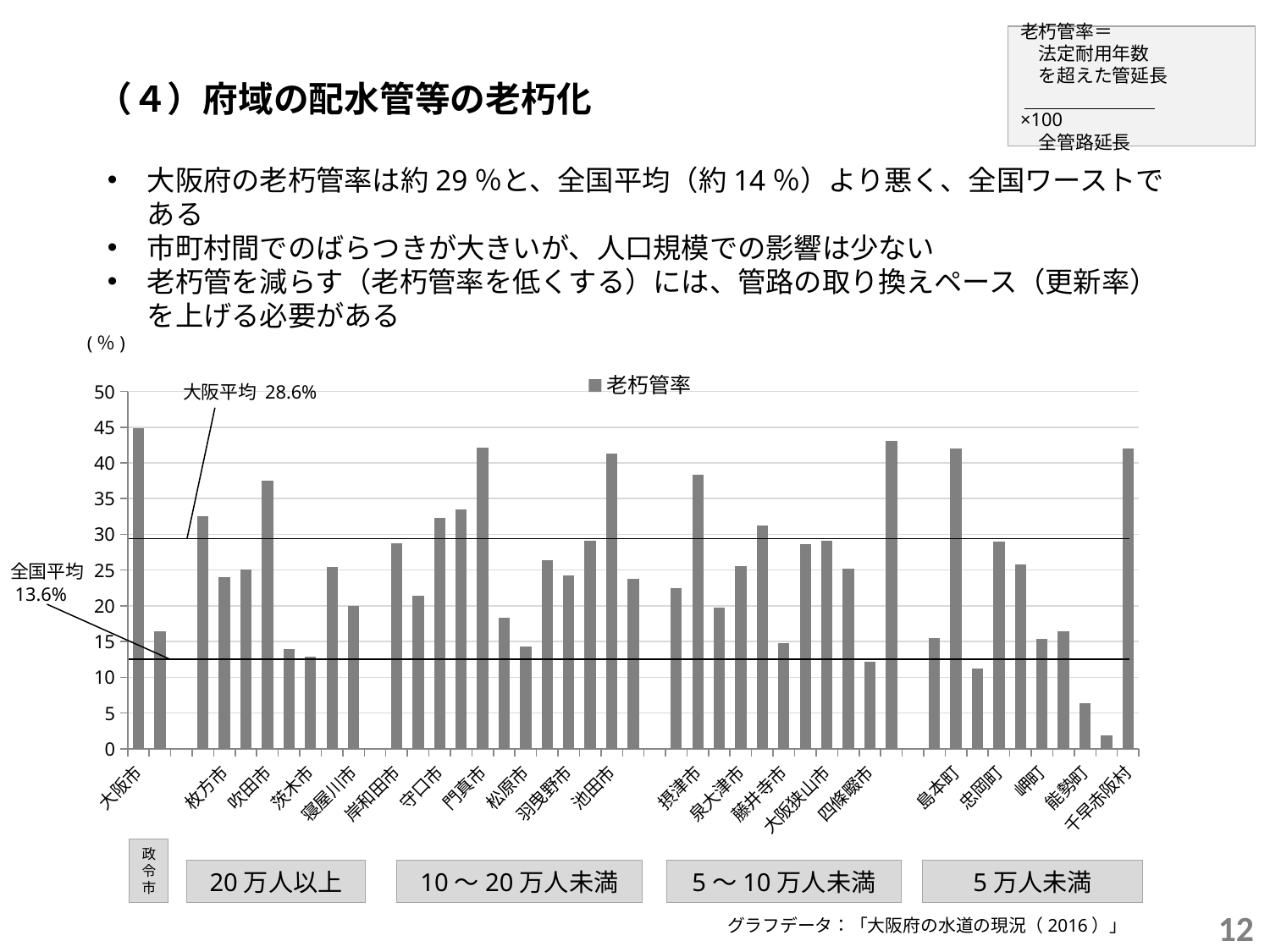
What value is given for 全国平均 on the chart? 13.6% Which has the larger value, 大阪市 or 能勢町? 大阪市 Is the value for 千早赤阪村 greater or less than 40? greater What value is given for 大阪平均 on the chart? 28.6% What unit is shown on the y axis of the chart? % How many series does the legend list? 1 What kind of chart is shown on the slide? bar chart What is the difference between 大阪平均 (28.6%) and 全国平均 (13.6%)? 15.0% Is the value for 大阪市 above or below the 大阪平均 line of 28.6%? above What is the name of the series shown in the legend? 老朽管率 Is the value for 大阪市 greater or less than 40? greater Is the value for 能勢町 greater or less than 10? less